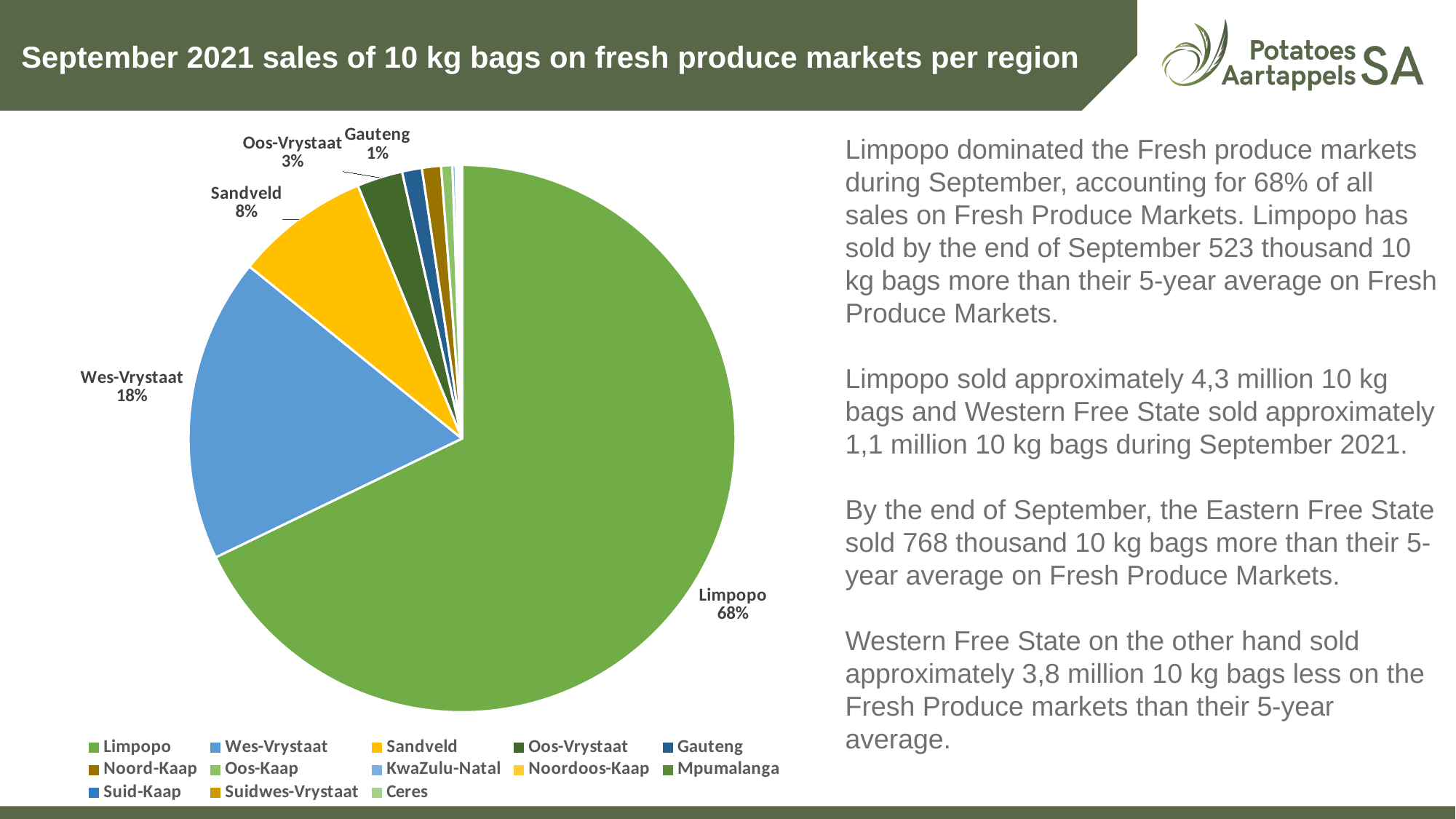
What is the difference in percentage points between Limpopo and Wes-Vrystaat? 50 Which region has the largest slice of the pie? Limpopo How many regions are listed in the chart legend? 13 What share of the pie does Limpopo account for? 68% What is the title of the slide containing the chart? September 2021 sales of 10 kg bags on fresh produce markets per region What is the difference in percentage points between Wes-Vrystaat and Sandveld? 10 What percentage is shown for Gauteng? 1% What percentage is shown for Wes-Vrystaat? 18% Which has a larger share, Sandveld or Oos-Vrystaat? Sandveld What percentage is shown for Oos-Vrystaat? 3% What type of chart is shown on the slide? Pie chart What percentage is shown for Sandveld? 8%